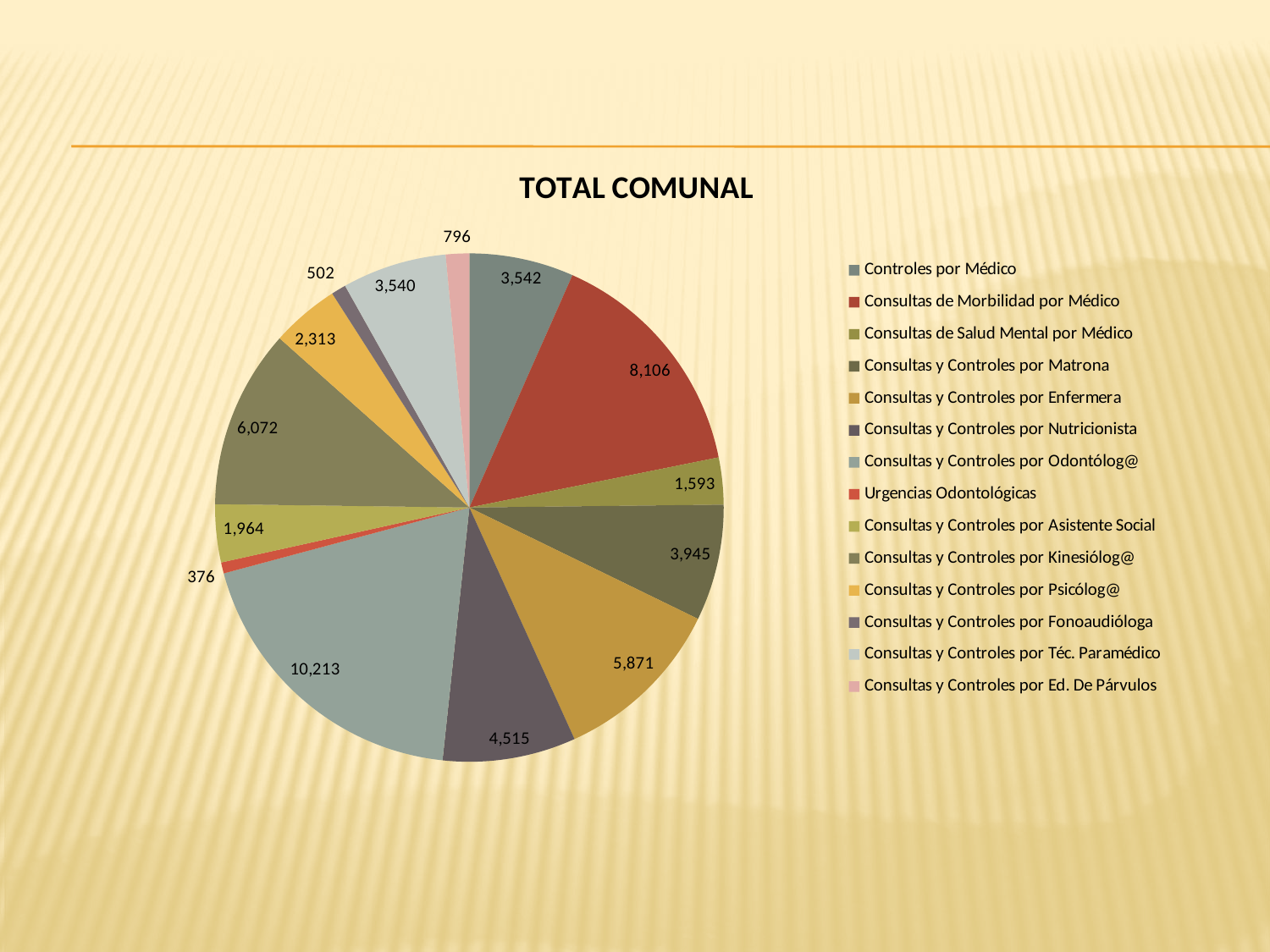
What is the value for Consultas y Controles por Enfermera? 5,871 Which is larger, Consultas y Controles por Kinesiólog@ or Consultas y Controles por Nutricionista? Consultas y Controles por Kinesiólog@ What is the difference between Consultas y Controles por Odontólog@ and Consultas de Morbilidad por Médico? 2,107 What is the difference between Consultas y Controles por Matrona and Controles por Médico? 403 Which category has the smallest slice? Urgencias Odontológicas What is the value for Consultas de Morbilidad por Médico? 8,106 What is the value for Urgencias Odontológicas? 376 What is the value for Consultas y Controles por Odontólog@? 10,213 What type of chart is shown on the slide? pie chart How many categories does the legend list? 14 What is the title of the chart? TOTAL COMUNAL Which category has the largest slice? Consultas y Controles por Odontólog@